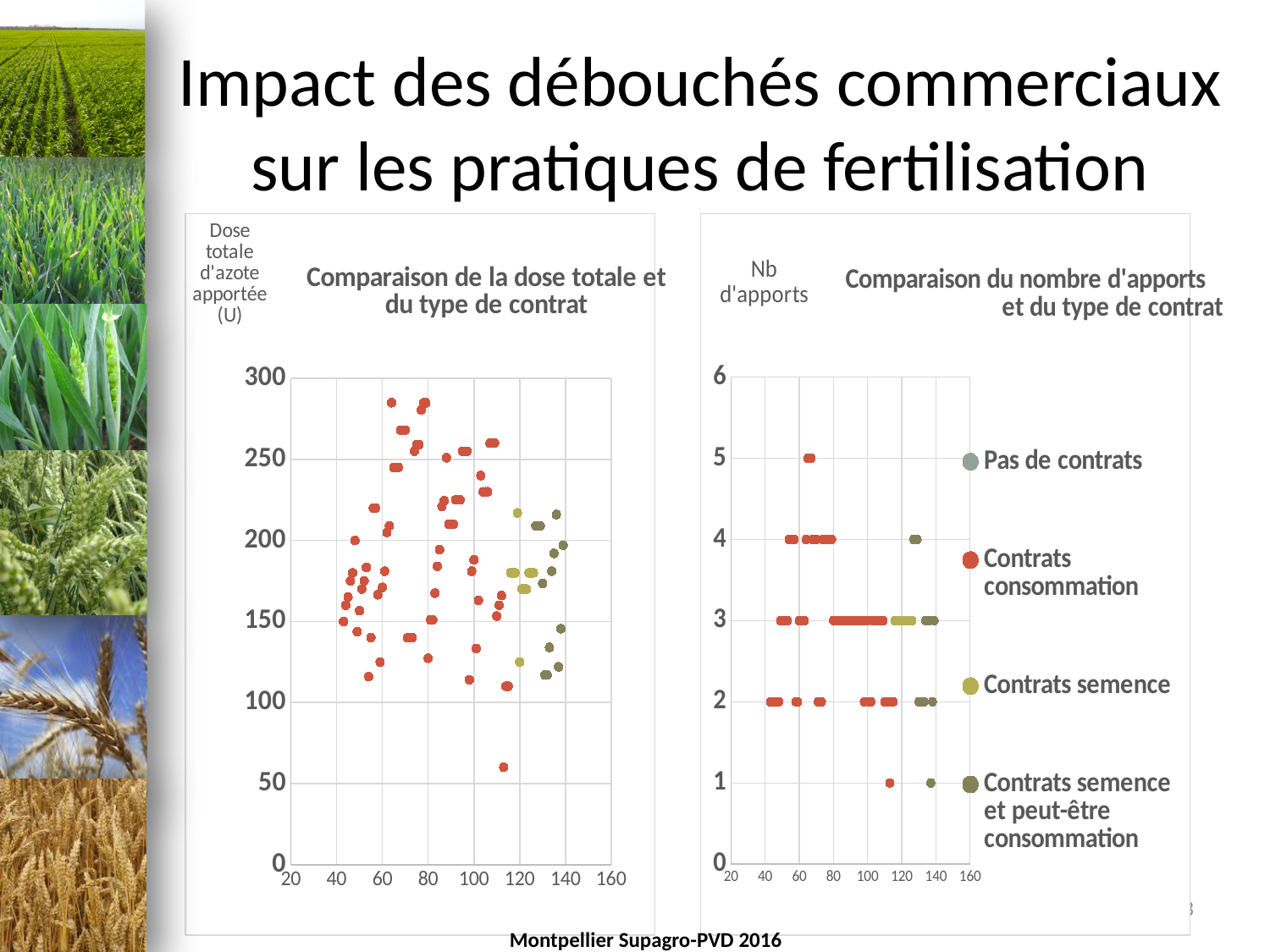
In the left chart, is the highest plotted dose value greater or less than 250? greater In the left chart, is the lowest plotted dose value greater or less than 100? less In the right chart, what is the label of the vertical axis? Nb d'apports In the left chart, what is the maximum value shown on the vertical axis? 300 In the right chart, what is the highest number of 'apports' reached by any plotted point? 5 What kind of chart is the right chart, 'Comparaison du nombre d'apports et du type de contrat'? Scatter chart In the right chart, is the highest plotted number of 'apports' greater or less than 4? greater In the right chart, how many series does the legend list? 4 What kind of chart is the left chart, 'Comparaison de la dose totale et du type de contrat'? Scatter chart In the right chart, what is the lowest number of 'apports' reached by any plotted point? 1 In the right chart, which series does the point at 5 'apports' belong to? Contrats consommation